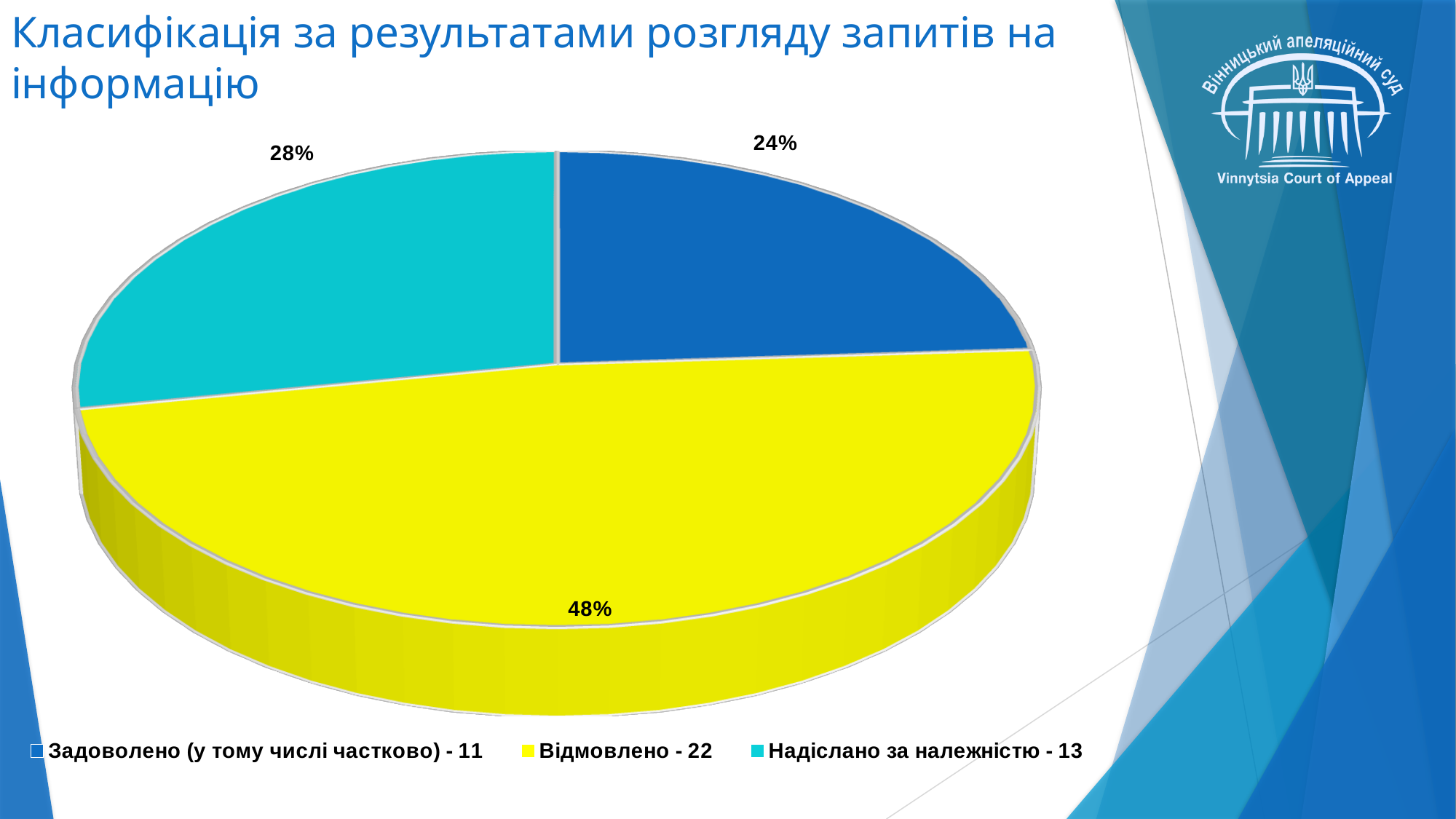
What is the title of the slide containing the pie chart? Класифікація за результатами розгляду запитів на інформацію What share of the pie does the slice "Задоволено (у тому числі частково) - 11" represent? 24% How many entries does the legend list? 3 What share of the pie does the slice "Відмовлено - 22" represent? 48% What share of the pie does the slice "Надіслано за належністю - 13" represent? 28% Which category has the smallest slice of the pie? Задоволено (у тому числі частково) - 11 What kind of chart is shown on the slide? Pie chart What colour is the slice for "Відмовлено - 22"? Yellow Which category has the largest slice of the pie? Відмовлено - 22 How many slices does the pie chart have? 3 Which slice is larger: "Надіслано за належністю" or "Задоволено (у тому числі частково)"? Надіслано за належністю What is the difference in percentage points between the "Відмовлено" slice and the "Надіслано за належністю" slice? 20